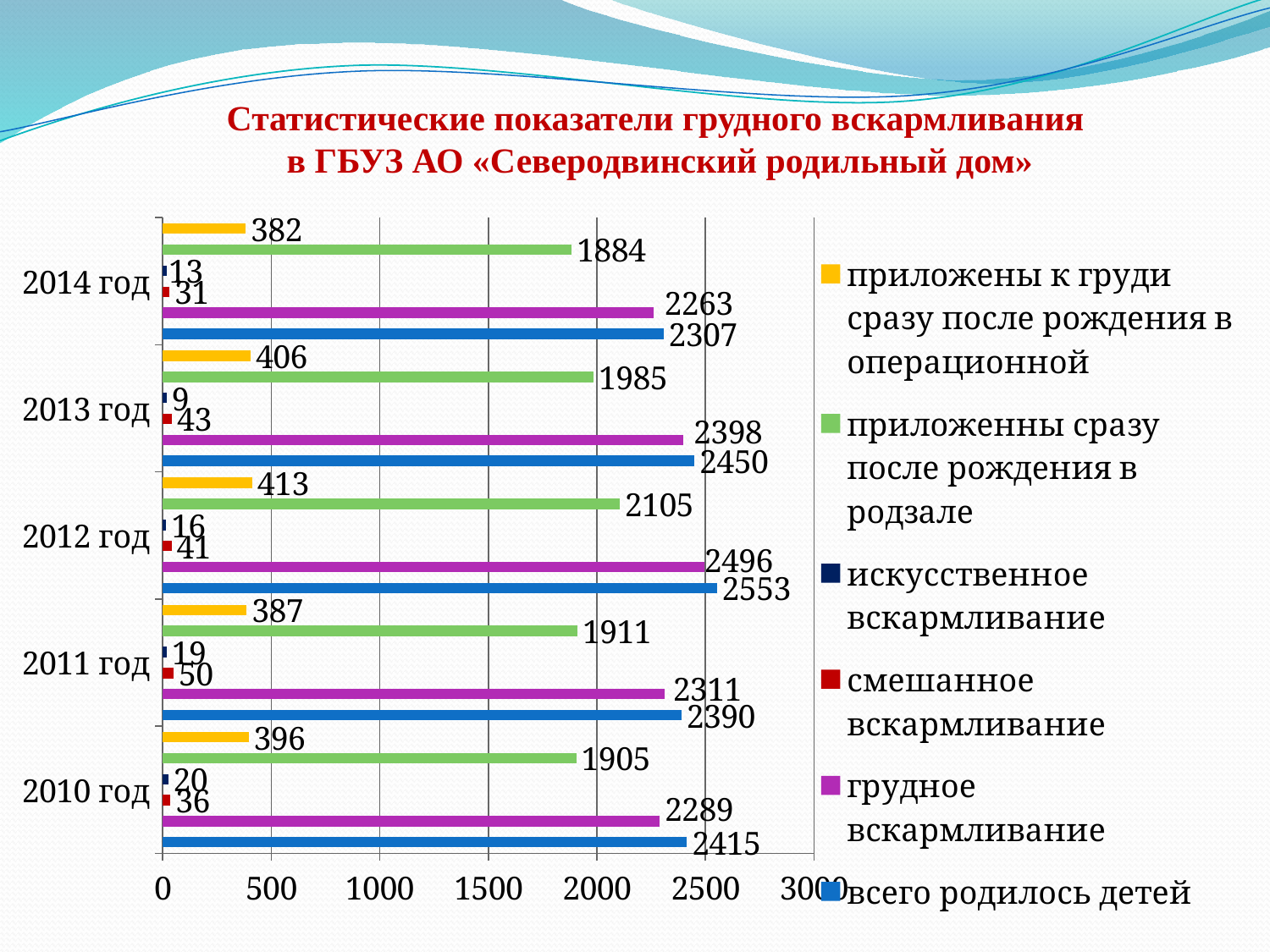
Is the value of «приложенны сразу после рождения в родзале» for 2012 год greater or less than 2000? greater What is the value of «грудное вскармливание» for 2014 год? 2263 How many years (categories) are shown on the chart? 5 Which colour represents «грудное вскармливание» in the legend? purple What is the difference between «всего родилось детей» and «грудное вскармливание» in 2010 год? 126 What is the value of «всего родилось детей» for 2012 год? 2553 In which year is «искусственное вскармливание» the lowest? 2013 год What type of chart is shown on the slide? bar chart How many series does the legend list? 6 Which is larger: «смешанное вскармливание» in 2011 год or in 2012 год? 2011 год In which year is «всего родилось детей» the highest? 2012 год What is the value of «приложены к груди сразу после рождения в операционной» for 2013 год? 406